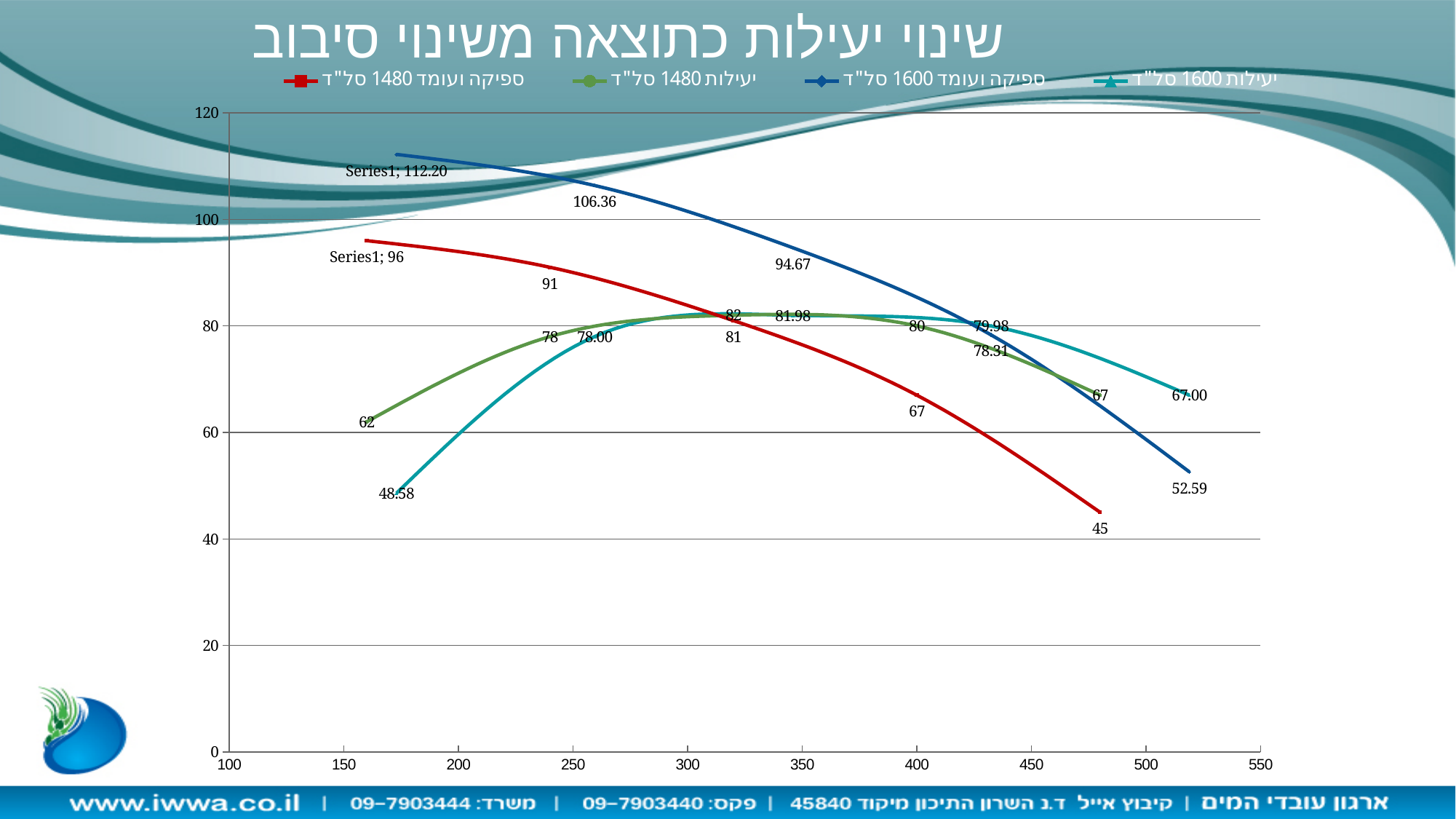
Which series starts higher at its first labelled point: ספיקה ועומד 1600 סל"ד (112.20) or ספיקה ועומד 1480 סל"ד (96)? ספיקה ועומד 1600 סל"ד What kind of chart is shown on the slide? line chart What is the first (leftmost) labelled value of the ספיקה ועומד 1600 סל"ד series? 112.20 What is the lowest labelled value of the ספיקה ועומד 1600 סל"ד series? 52.59 What is the difference between the first and last labelled values of the ספיקה ועומד 1600 סל"ד series (112.20 and 52.59)? 59.61 Is the first labelled value of the יעילות 1600 סל"ד series greater or less than 60? less Does the ספיקה ועומד 1480 סל"ד series rise or fall as the x-axis value increases? fall What is the peak labelled value of the יעילות 1480 סל"ד series? 82 What is the last (rightmost) labelled value of the יעילות 1600 סל"ד series? 67.00 How many series does the legend list? 4 What is the highest labelled value of the ספיקה ועומד 1480 סל"ד series? 96 What is the last (rightmost) labelled value of the ספיקה ועומד 1480 סל"ד series? 45